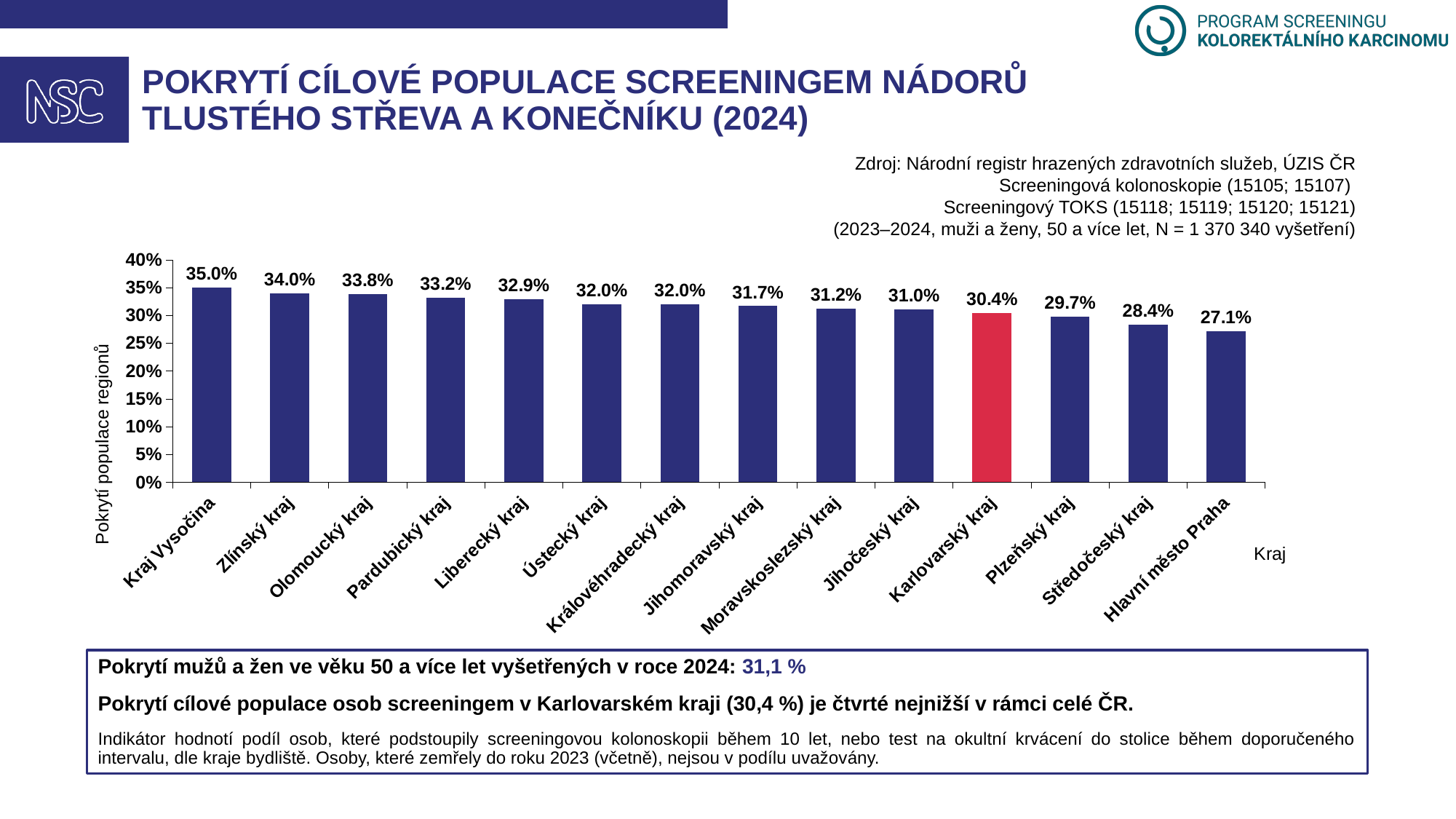
Is the value for Zlínský kraj greater or less than 30%? greater What is the difference between the values for Kraj Vysočina and Hlavní město Praha? 7.9% What is the value for Hlavní město Praha? 27.1% What is the value for Jihomoravský kraj? 31.7% Which region has the highest value? Kraj Vysočina Which region has the lowest value? Hlavní město Praha What kind of chart is shown on the slide? bar chart How many regions are shown on the x axis? 14 Which bar is highlighted in red? Karlovarský kraj What is the value for Karlovarský kraj? 30.4% What is the value for Kraj Vysočina? 35.0% Which is larger, the value for Plzeňský kraj or the value for Středočeský kraj? Plzeňský kraj